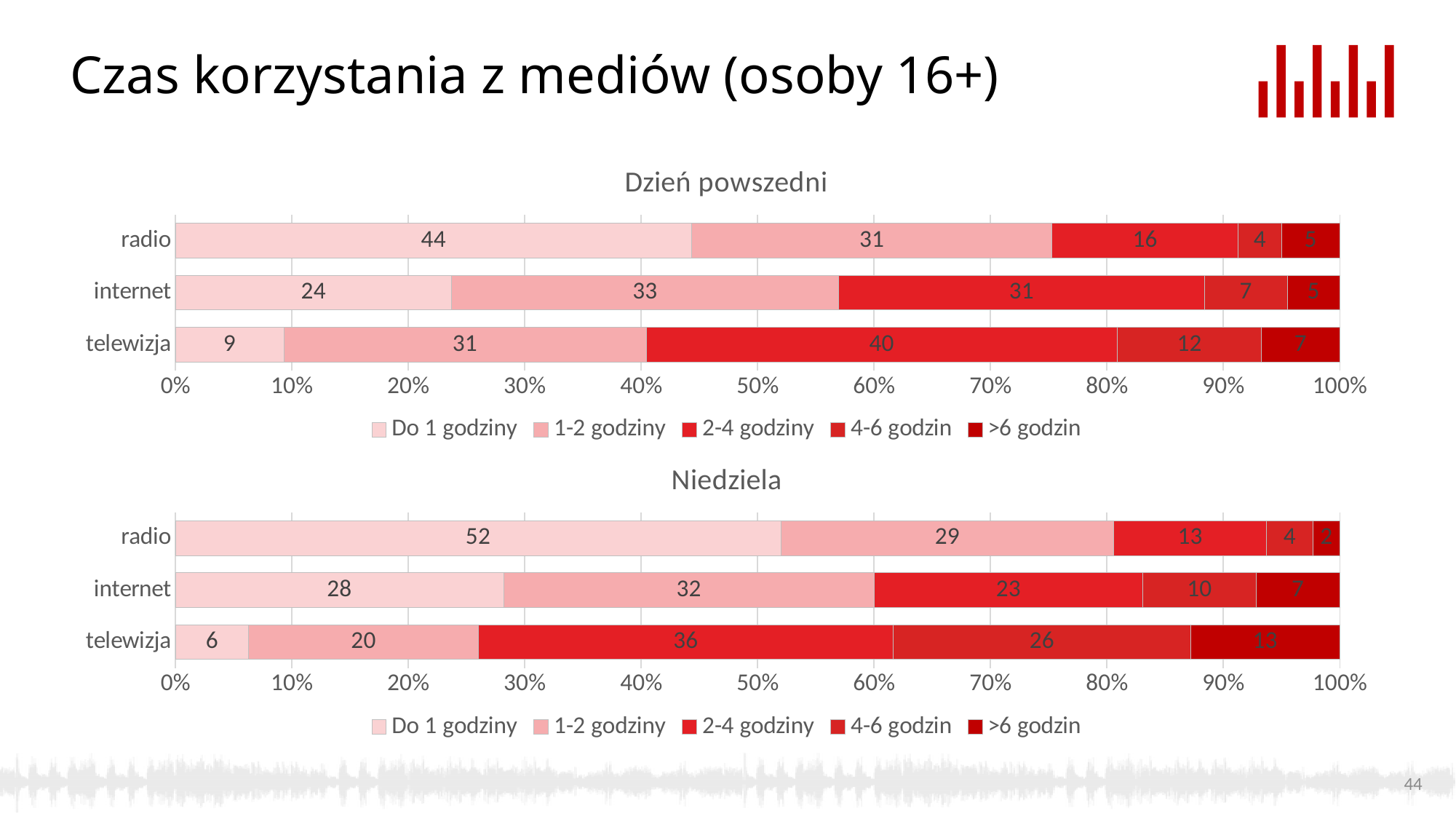
How many series does the legend of the 'Dzień powszedni' chart list? 5 In the 'Dzień powszedni' chart, what is the value of 'Do 1 godziny' for radio? 44 What is the title of the top chart on the slide? Dzień powszedni What type of chart is the 'Niedziela' chart? Stacked bar chart In the 'Dzień powszedni' chart, is the '1-2 godziny' value for internet larger than the '1-2 godziny' value for telewizja? Yes, internet (33) is larger than telewizja (31) In the 'Dzień powszedni' chart, which category has the lowest value for '2-4 godziny'? radio In the 'Dzień powszedni' chart, what is the total of the stacked bar for internet? 100 In the 'Niedziela' chart, which category has the highest value for 'Do 1 godziny'? radio In the 'Niedziela' chart, what is the value of '4-6 godzin' for telewizja? 26 In the 'Niedziela' chart, what is the difference between the '2-4 godziny' values for telewizja and internet? 13 How many categories are shown in the 'Niedziela' chart? 3 In the 'Dzień powszedni' chart, what is the value of '2-4 godziny' for internet? 31